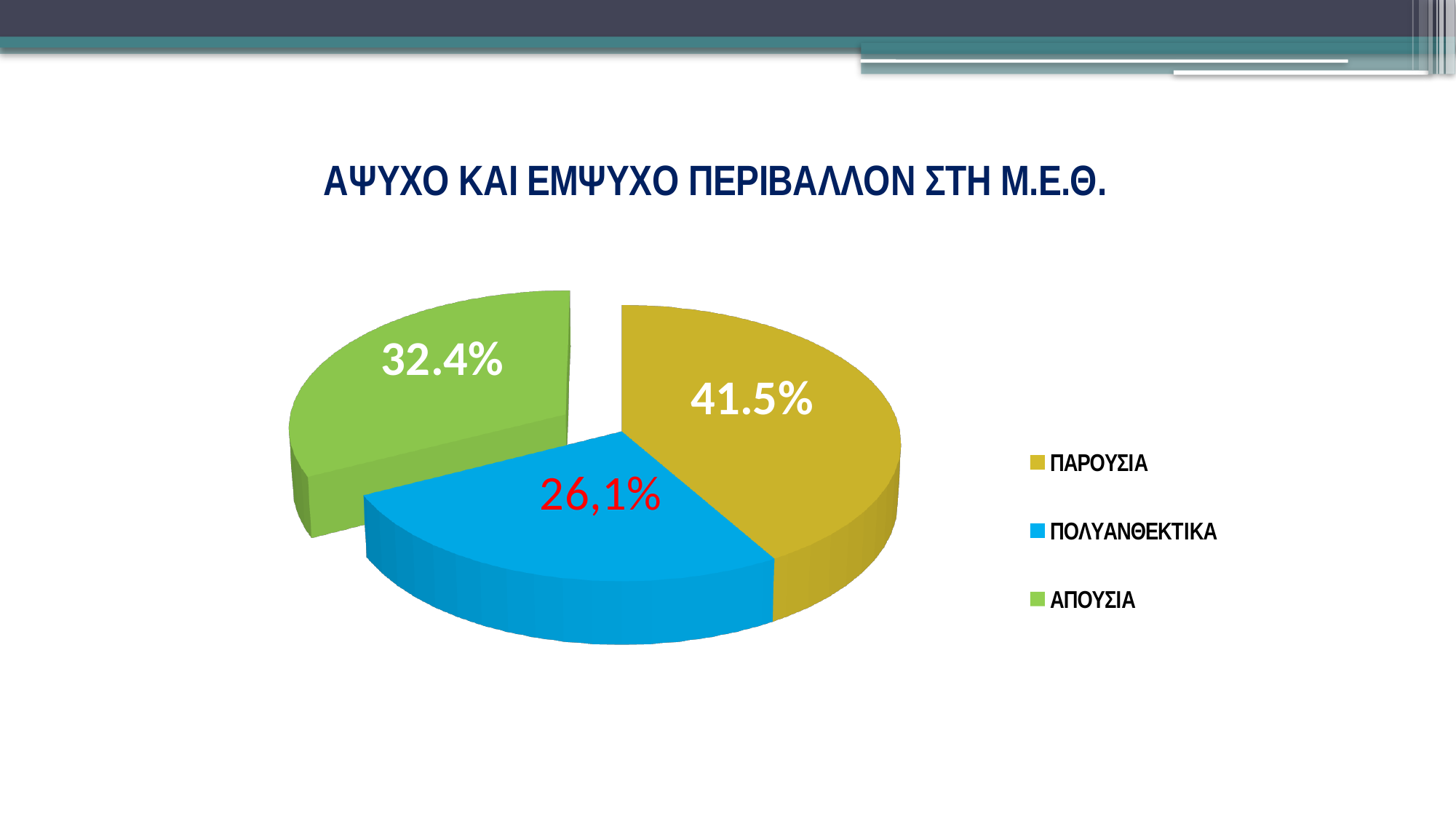
What colour is the ΑΠΟΥΣΙΑ slice? Green What is the title of the chart? ΑΨΥΧΟ ΚΑΙ ΕΜΨΥΧΟ ΠΕΡΙΒΑΛΛΟΝ ΣΤΗ Μ.Ε.Θ. How many percentage points larger is the ΠΑΡΟΥΣΙΑ share than the ΑΠΟΥΣΙΑ share? 9.1 percentage points What percentage is shown for ΠΟΛΥΑΝΘΕΚΤΙΚΑ? 26,1% Which is larger, the share for ΑΠΟΥΣΙΑ or the share for ΠΟΛΥΑΝΘΕΚΤΙΚΑ? ΑΠΟΥΣΙΑ What percentage is shown for ΑΠΟΥΣΙΑ? 32.4% Which category has the largest share of the pie? ΠΑΡΟΥΣΙΑ How many slices does the pie chart have? 3 What percentage is shown for ΠΑΡΟΥΣΙΑ? 41.5% How many entries does the legend list? 3 Which category has the smallest share of the pie? ΠΟΛΥΑΝΘΕΚΤΙΚΑ What kind of chart is shown on the slide? Pie chart